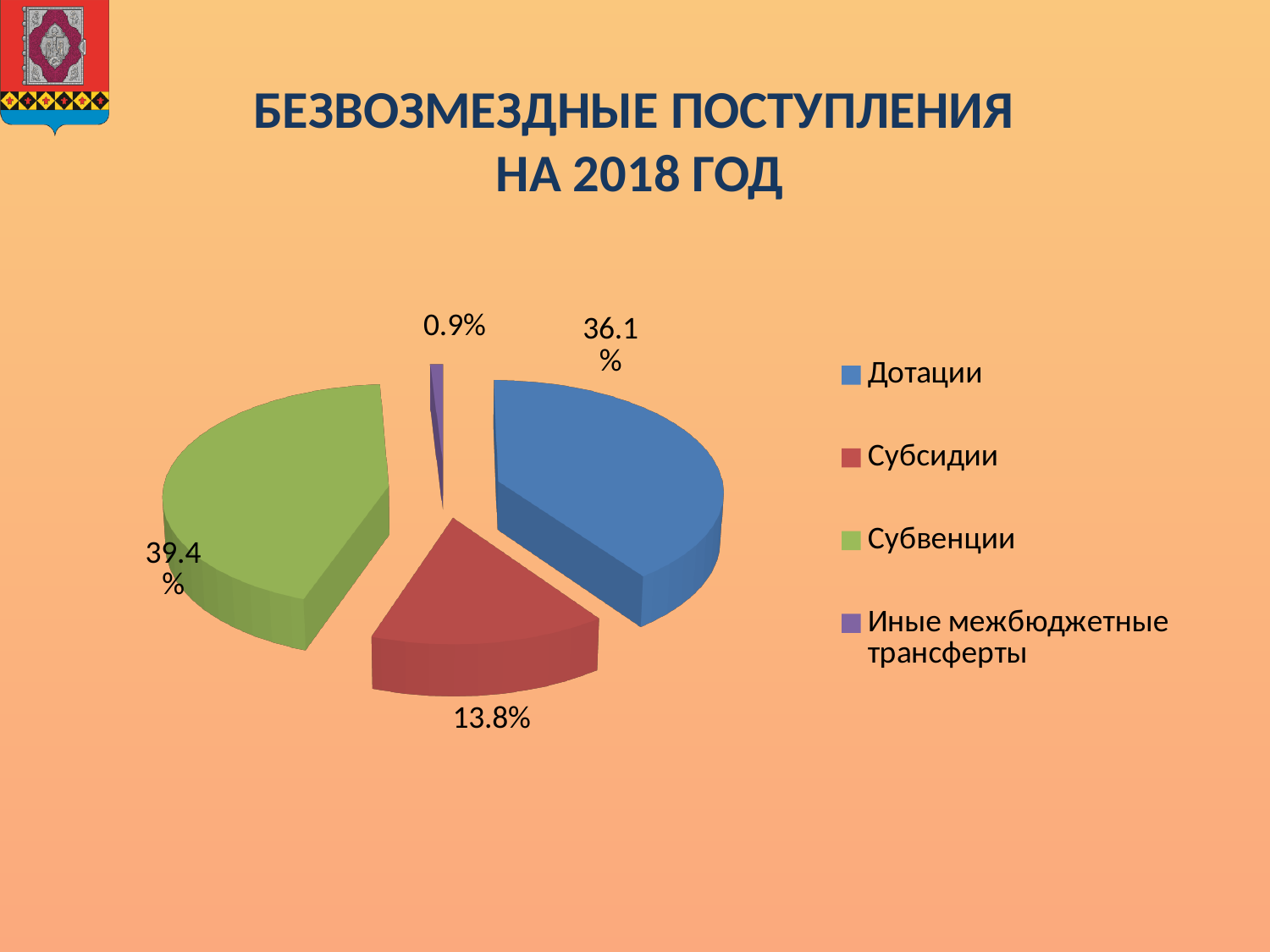
What is the difference between the shares of Субвенции and Дотации? 3.3% What is the difference between the shares of Дотации and Субсидии? 22.3% What share of the pie does Субвенции have? 39.4% What kind of chart is shown on the slide? pie chart What share of the pie does Иные межбюджетные трансферты have? 0.9% What share of the pie does Субсидии have? 13.8% How many slices does the pie chart have? 4 Which is larger, the share of Субсидии or the share of Дотации? Дотации Which category has the largest share of the pie? Субвенции What is the title of the chart on the slide? БЕЗВОЗМЕЗДНЫЕ ПОСТУПЛЕНИЯ НА 2018 ГОД Which category has the smallest share of the pie? Иные межбюджетные трансферты